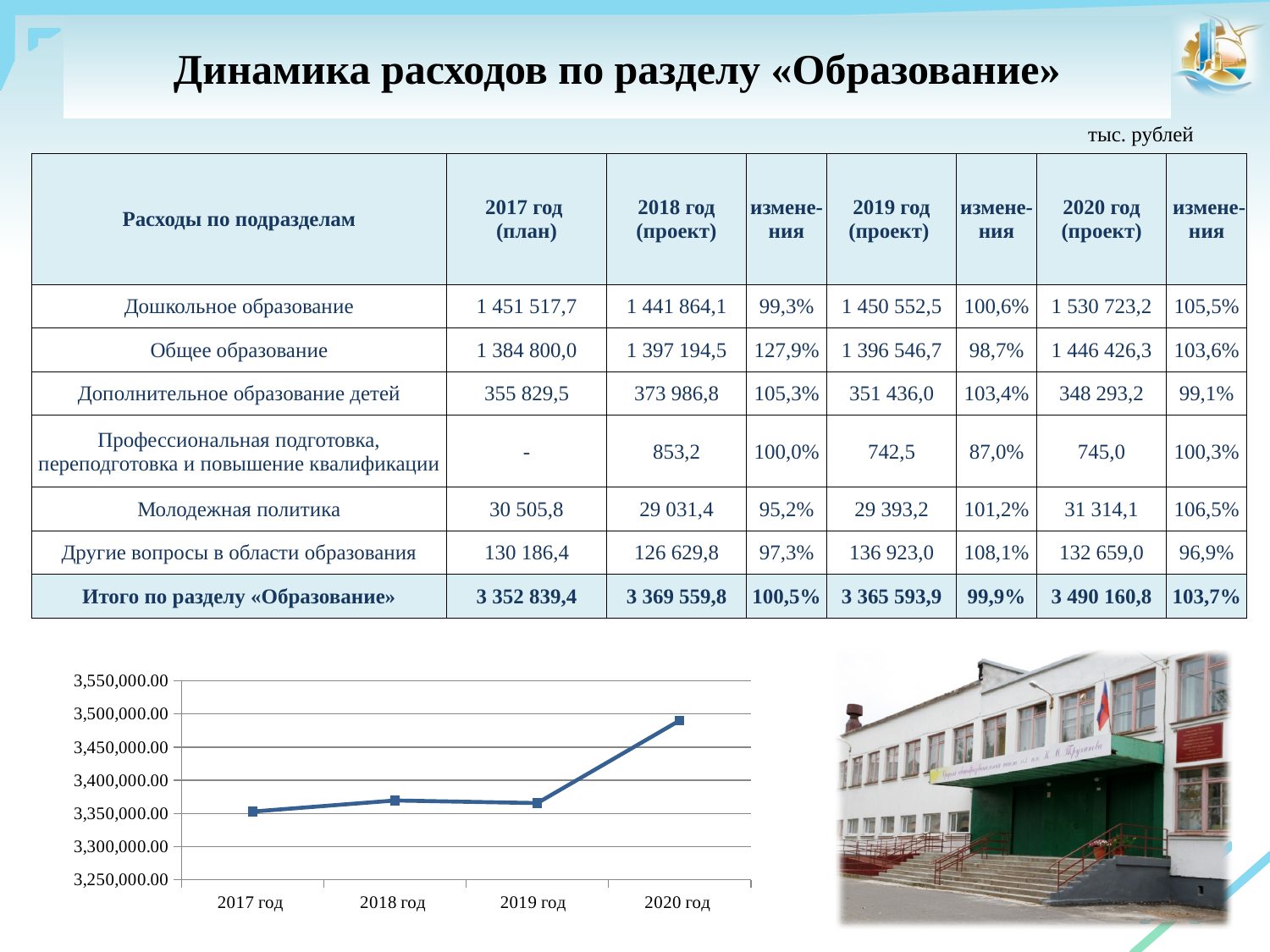
What kind of chart is shown at the bottom left of the slide? line chart How many years are plotted on the x axis of the line chart? 4 In the line chart, is the value for 2020 год greater or less than 3,450,000.00? greater Do the values in the line chart generally rise or fall from 2017 год to 2020 год? rise In the line chart, which is larger: the value for 2020 год or the value for 2018 год? 2020 год In the line chart, is the value for 2017 год greater or less than 3,400,000.00? less What is the lowest value shown on the y axis of the line chart? 3,250,000.00 Which year has the lowest value in the line chart? 2017 год Which year has the highest value in the line chart? 2020 год In the line chart, is the value for 2018 год greater or less than 3,400,000.00? less